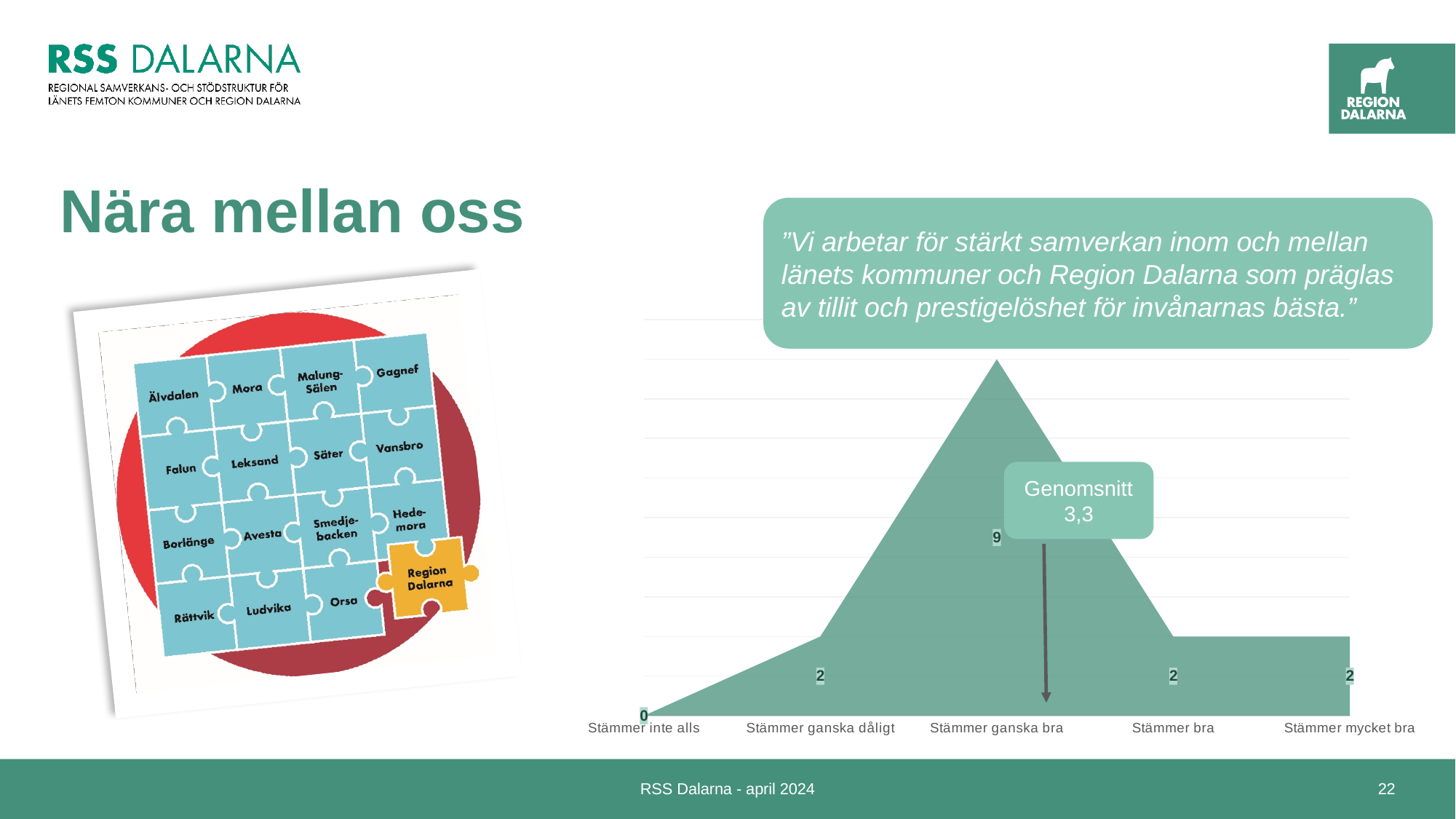
What average (Genomsnitt) value is shown in the callout on the chart? 3,3 What is the value for "Stämmer ganska bra"? 9 Which category has the lowest value? Stämmer inte alls What is the value for "Stämmer mycket bra"? 2 Which is larger, the value for "Stämmer ganska bra" or the value for "Stämmer ganska dåligt"? Stämmer ganska bra How many categories are shown on the x axis of the chart? 5 What is the value for "Stämmer inte alls"? 0 What is the total of all the values plotted in the chart? 15 What is the difference between the values for "Stämmer ganska bra" and "Stämmer bra"? 7 Which category has the highest value? Stämmer ganska bra What kind of chart is shown on the slide? Area chart What is the value for "Stämmer ganska dåligt"? 2